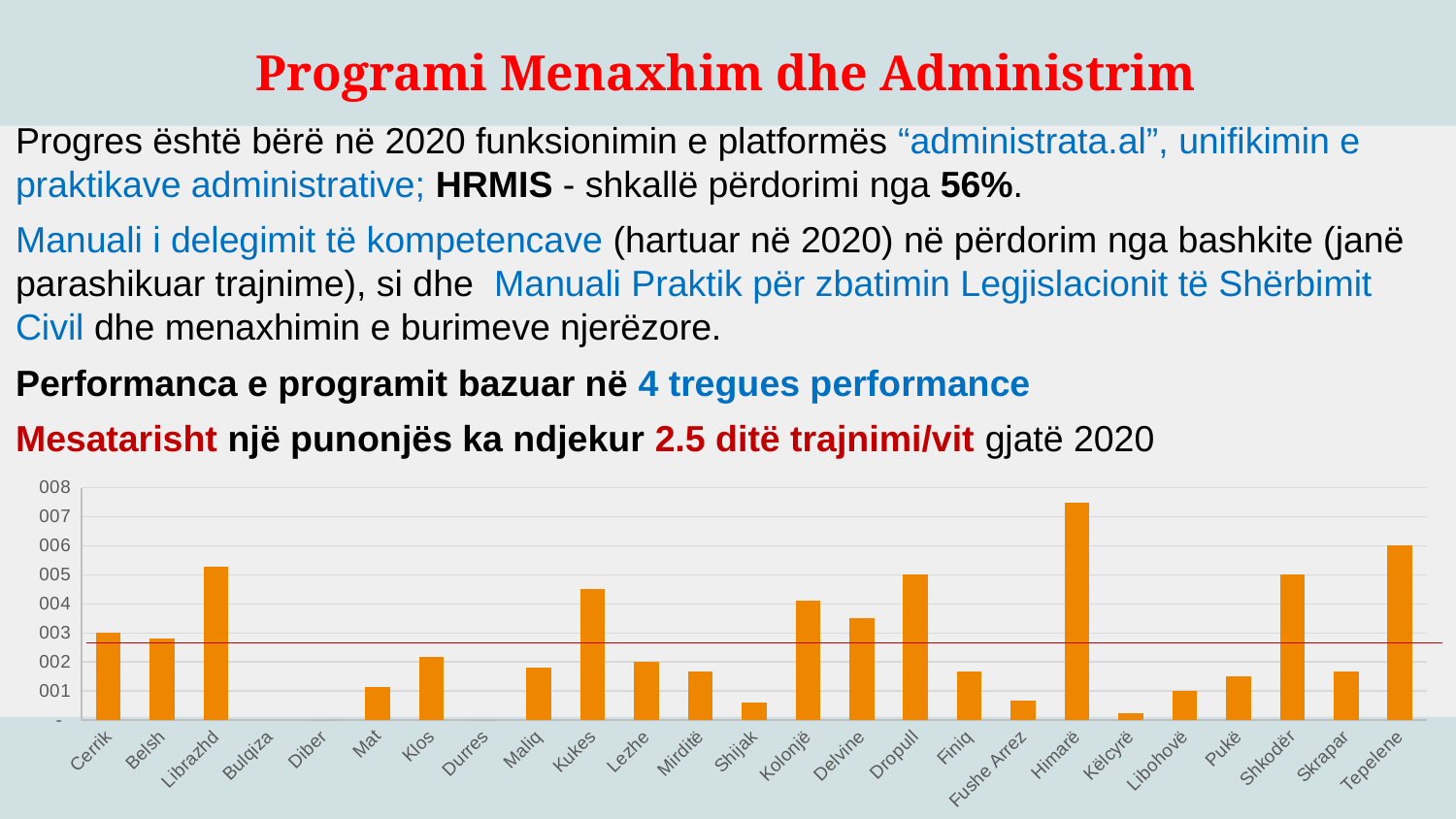
Which is larger, the value for Dropull or the value for Finiq? Dropull What kind of chart is shown on the slide? bar chart Which municipality has the highest bar in the chart? Himarë Is the value for Kukes greater or less than 4? greater Is the value for Delvine greater or less than 3? greater Is the value for Himarë greater or less than 7? greater Which is larger, the value for Himarë or the value for Tepelene? Himarë How many municipalities (categories) are shown on the x axis of the chart? 25 What colour are the bars in the chart? orange